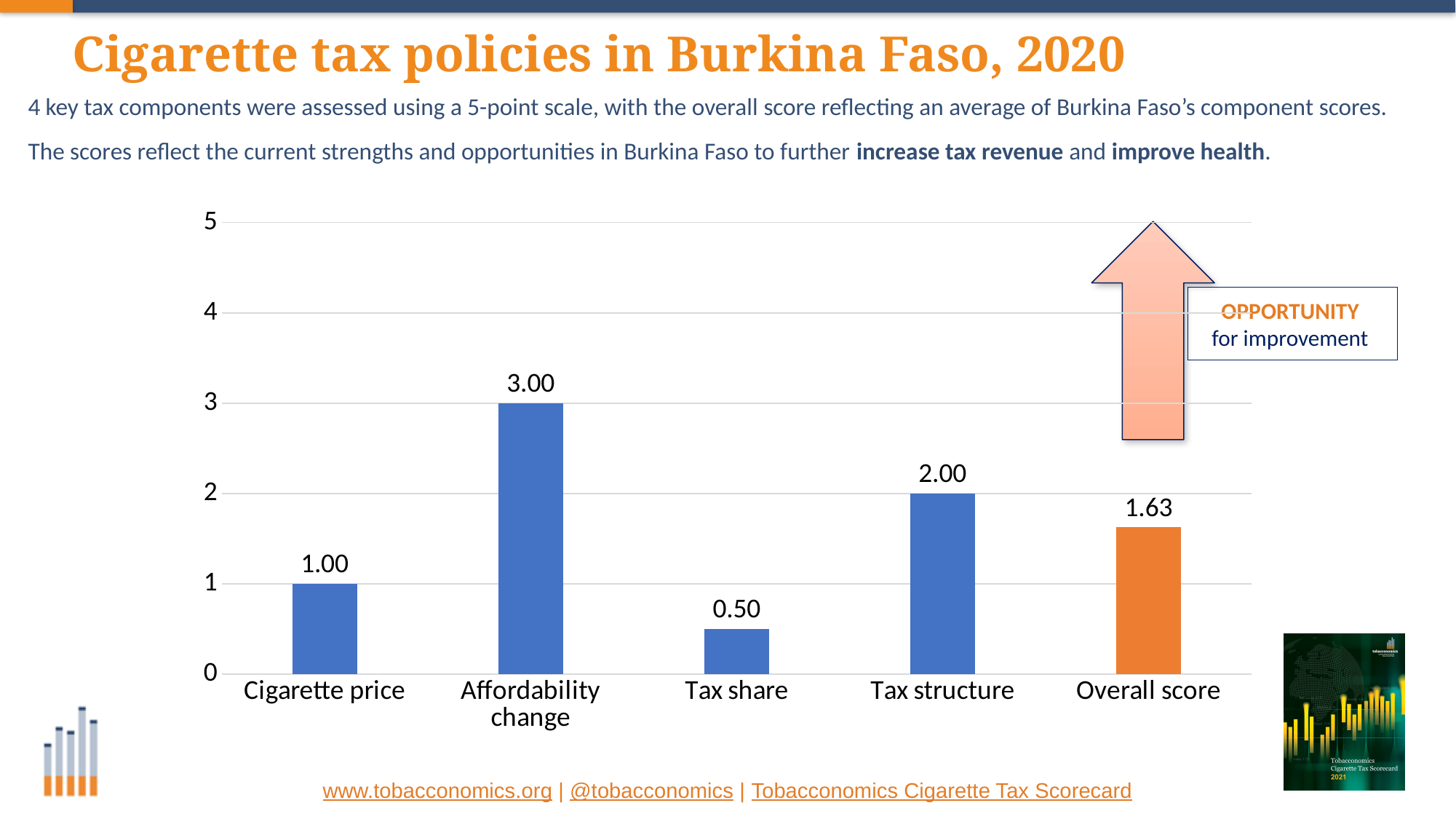
What is the value for Cigarette price? 1.00 What is the Overall score? 1.63 What is the value for Tax share? 0.50 Which category has the lowest value? Tax share What colour is the Overall score bar? Orange Which is larger, the value for Cigarette price or the value for Tax share? Cigarette price What kind of chart is shown on the slide? Bar chart What is the difference between the values for Affordability change and Tax structure? 1.00 How many bars are shown in the chart? 5 Which category has the highest value? Affordability change What is the value for Affordability change? 3.00 What is the value for Tax structure? 2.00